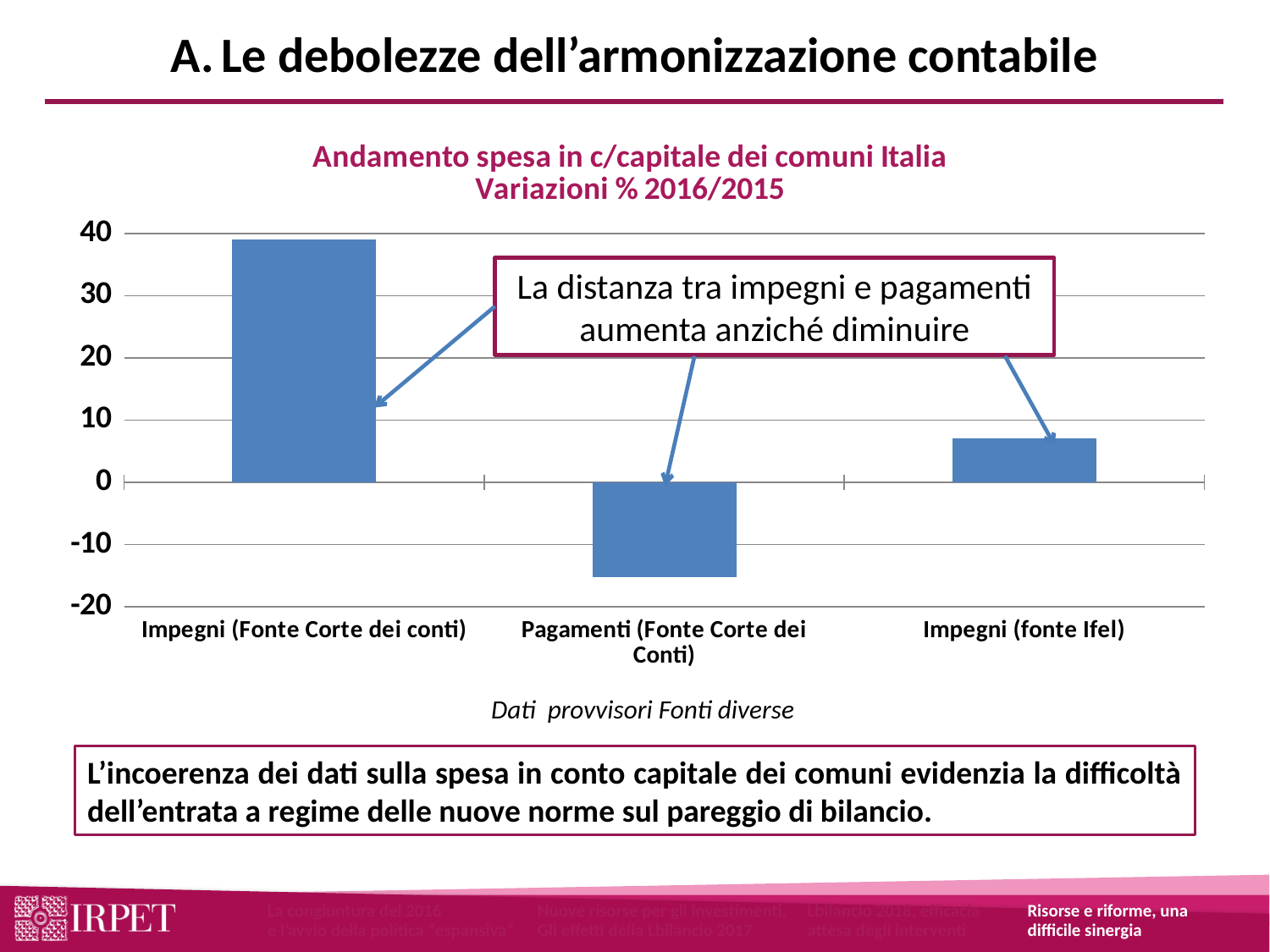
What is the title of the chart? Andamento spesa in c/capitale dei comuni Italia Variazioni % 2016/2015 Which category has the lowest value? Pagamenti (Fonte Corte dei Conti) Is the value for Impegni (fonte Ifel) greater or less than 10? less What is the lowest value shown on the vertical axis of the chart? -20 Which is larger, the value for Impegni (Fonte Corte dei conti) or the value for Impegni (fonte Ifel)? Impegni (Fonte Corte dei conti) Is the value for Impegni (fonte Ifel) greater or less than 0? greater Which is larger, the value for Pagamenti (Fonte Corte dei Conti) or the value for Impegni (fonte Ifel)? Impegni (fonte Ifel) Is the value for Impegni (Fonte Corte dei conti) greater or less than 30? greater Which category has the highest value? Impegni (Fonte Corte dei conti) How many categories are plotted in the chart? 3 What kind of chart is shown on the slide? bar chart